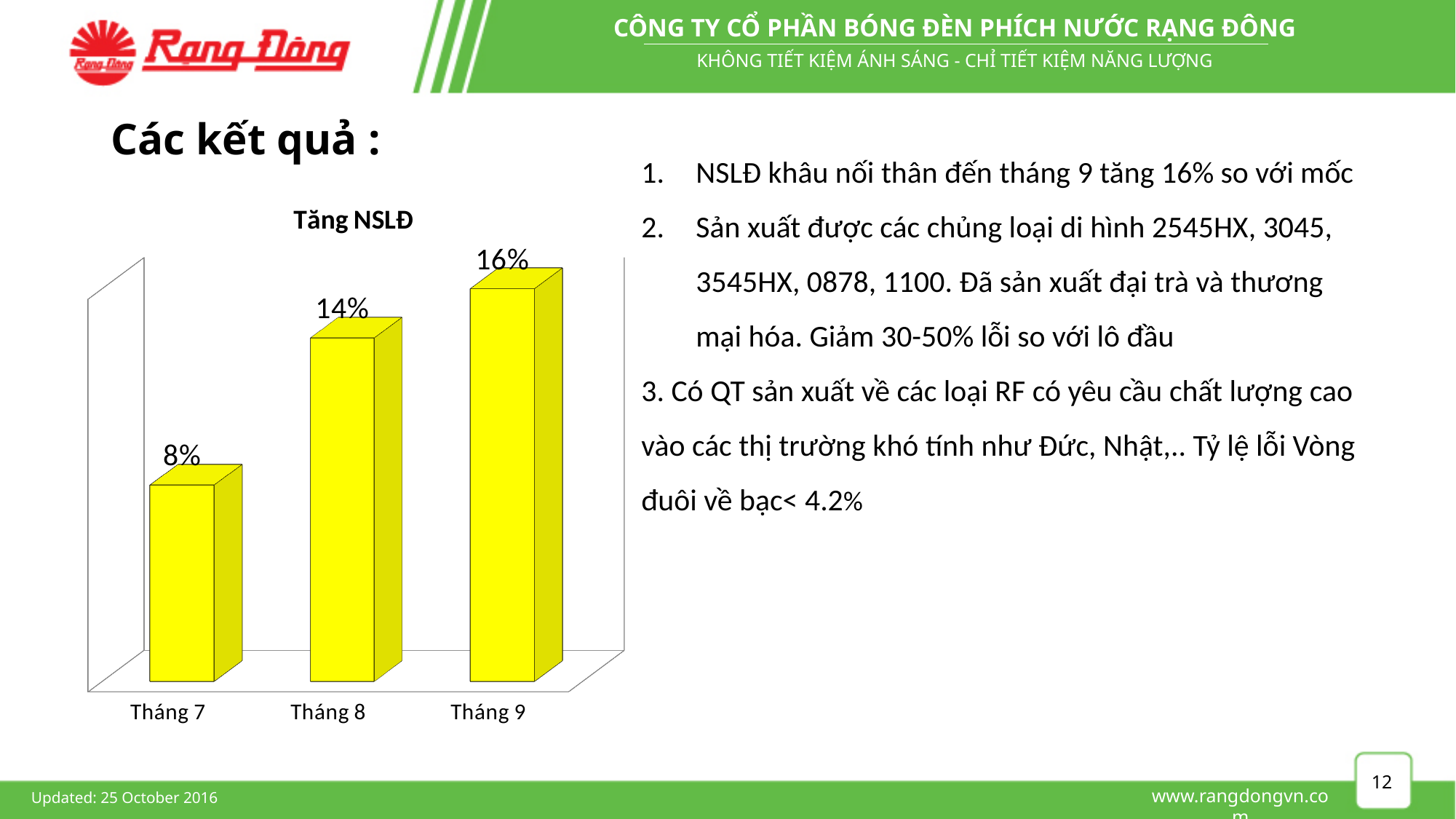
Do the values rise or fall from Tháng 7 to Tháng 9? Rise What is the difference between the values for Tháng 9 and Tháng 7? 8% What kind of chart is shown on the slide? Bar chart Which month has the highest value in the Tăng NSLĐ chart? Tháng 9 What is the value for Tháng 9 in the Tăng NSLĐ chart? 16% What is the title of the chart on the slide? Tăng NSLĐ What is the difference between the values for Tháng 8 and Tháng 7? 6% What is the value for Tháng 8 in the Tăng NSLĐ chart? 14% How many categories are shown in the Tăng NSLĐ chart? 3 Which month has the lowest value in the Tăng NSLĐ chart? Tháng 7 What is the value for Tháng 7 in the Tăng NSLĐ chart? 8% Which is larger, the value for Tháng 8 or the value for Tháng 9? Tháng 9